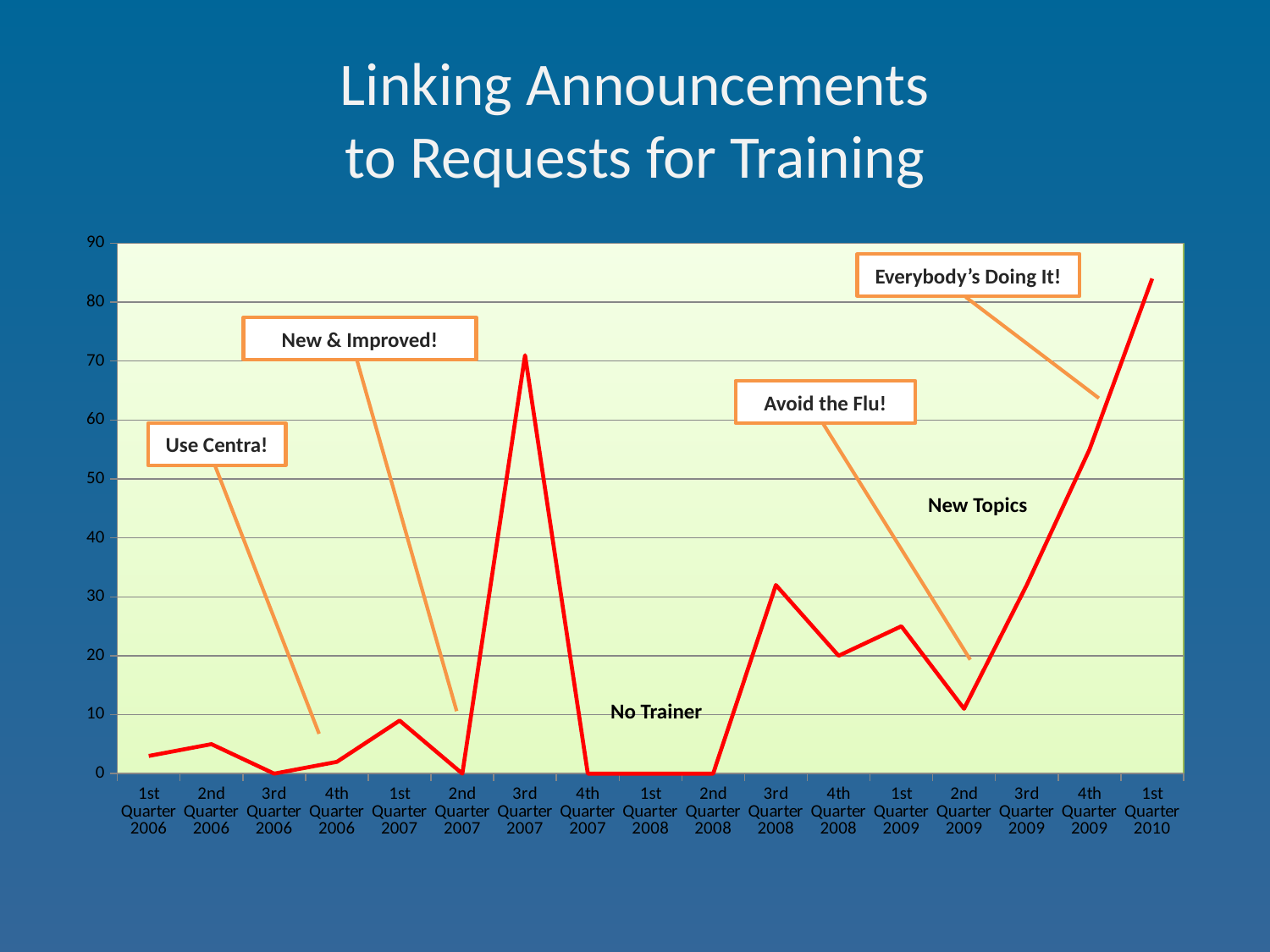
Is the value for 2nd Quarter 2009 greater or less than 20? less What kind of chart is shown on the slide? line chart Which quarter has the highest value? 1st Quarter 2010 Do the values rise or fall from 2nd Quarter 2009 to 1st Quarter 2010? rise What is the value for 4th Quarter 2007? 0 What is the title of the slide? Linking Announcements to Requests for Training What is the value for 2nd Quarter 2007? 0 How many quarters are plotted along the x axis? 17 Is the value for 3rd Quarter 2007 greater or less than 60? greater Is the value for 3rd Quarter 2008 greater or less than 40? less Which is larger, the value for 3rd Quarter 2007 or the value for 3rd Quarter 2008? 3rd Quarter 2007